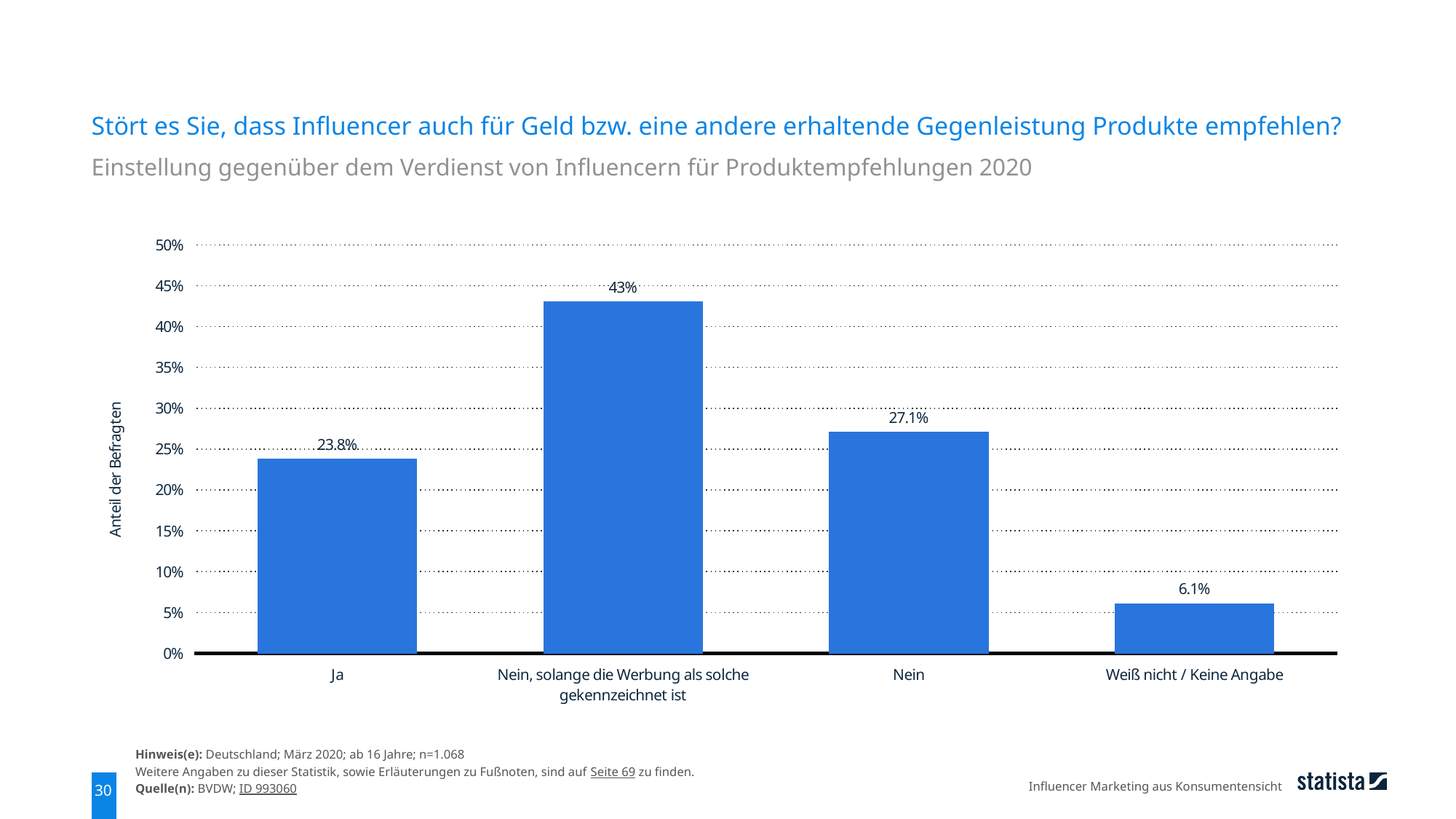
Which category has the lowest value? Weiß nicht / Keine Angabe What is the label of the y axis? Anteil der Befragten Which is larger, the value for "Ja" or the value for "Nein"? Nein What kind of chart is shown on the slide? bar chart What is the value for "Nein"? 27.1% What is the value for "Ja"? 23.8% What is the value for "Nein, solange die Werbung als solche gekennzeichnet ist"? 43% What is the difference between the values for "Nein" and "Ja"? 3.3% How many categories are shown on the x axis? 4 Is the value for "Weiß nicht / Keine Angabe" greater or less than 10%? less Which category has the highest value? Nein, solange die Werbung als solche gekennzeichnet ist What is the value for "Weiß nicht / Keine Angabe"? 6.1%